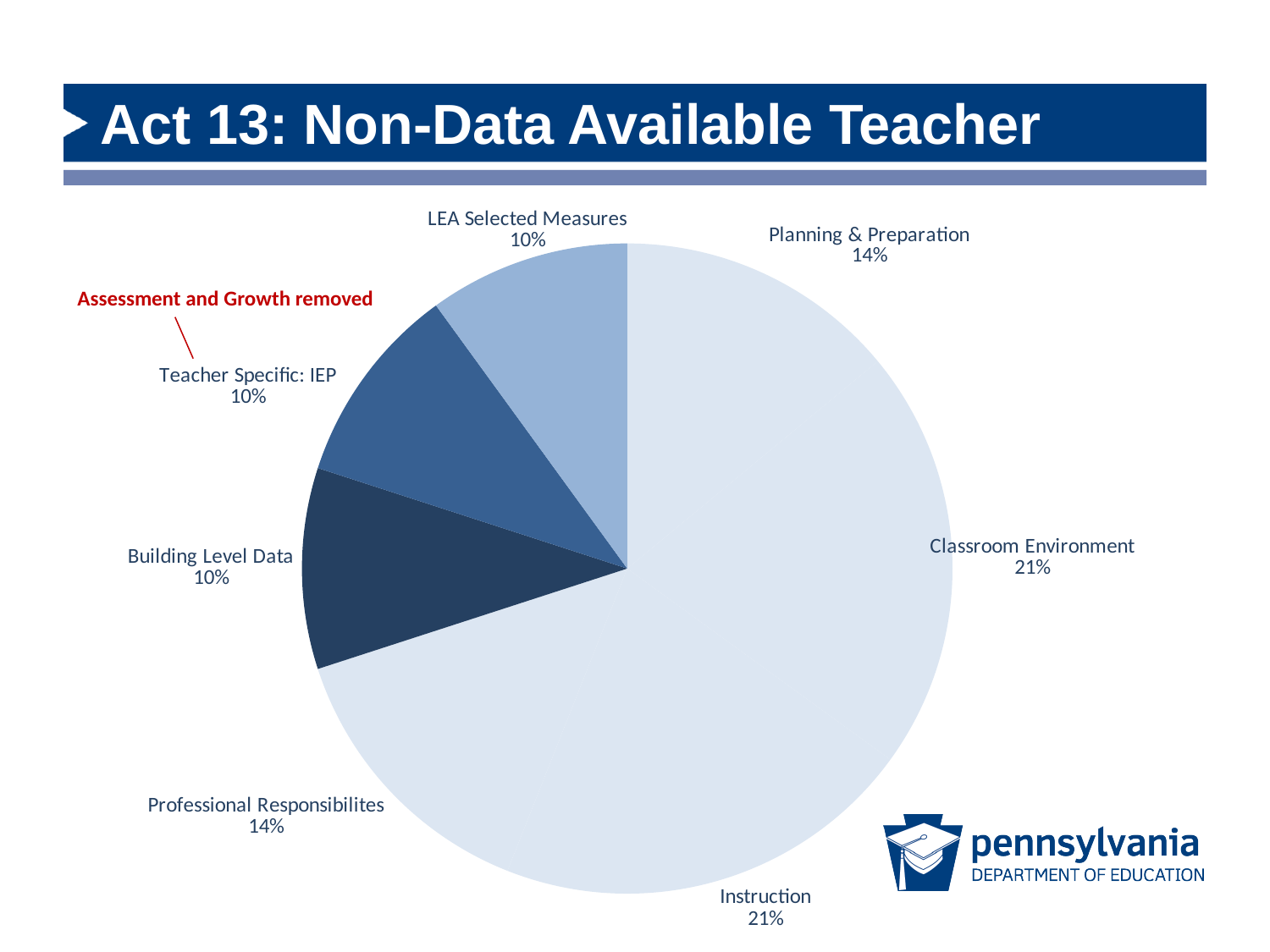
What share of the pie is Building Level Data? 10% What does the red annotation next to the Teacher Specific: IEP slice say? Assessment and Growth removed Which is larger, Professional Responsibilites or Building Level Data? Professional Responsibilites What is the difference between Planning & Preparation and Teacher Specific: IEP? 4% What percentage is labelled for Teacher Specific: IEP? 10% How many slices are labelled in the pie chart? 7 What is the value shown for Instruction? 21% What type of chart is shown on the slide? pie chart What is the title of the slide containing the pie chart? Act 13: Non-Data Available Teacher What is the difference between the Instruction share and the LEA Selected Measures share? 11% What percentage does the Classroom Environment slice represent? 21% What percentage is shown for Planning & Preparation? 14%